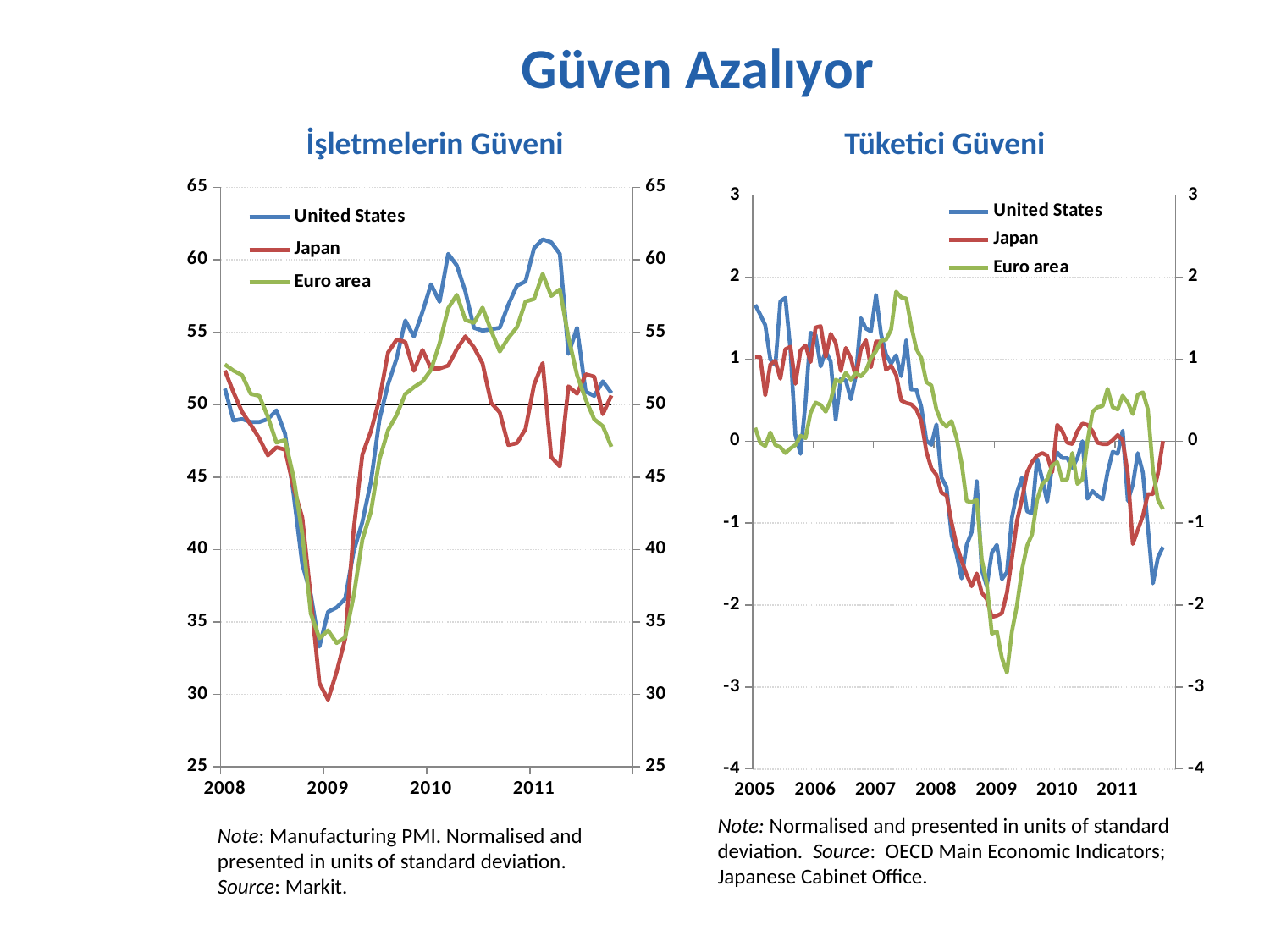
In the Tüketici Güveni chart, which year is the first label on the x axis? 2005 What is the title of the slide? Güven Azalıyor In the Tüketici Güveni chart, which series reaches the lowest value in 2009? Euro area In the Tüketici Güveni chart, is the lowest value for Euro area greater or less than -2? less In the İşletmelerin Güveni chart, is the peak value for United States in 2011 greater or less than 60? greater In the İşletmelerin Güveni chart, is the lowest value for Japan greater or less than 35? less In the İşletmelerin Güveni chart, which series reaches the lowest value in early 2009? Japan In the İşletmelerin Güveni chart, do the values rise or fall between 2008 and early 2009? fall How many series does the legend of the İşletmelerin Güveni chart list? 3 What kind of chart is the İşletmelerin Güveni chart? line chart What kind of chart is the Tüketici Güveni chart? line chart How many series does the legend of the Tüketici Güveni chart list? 3